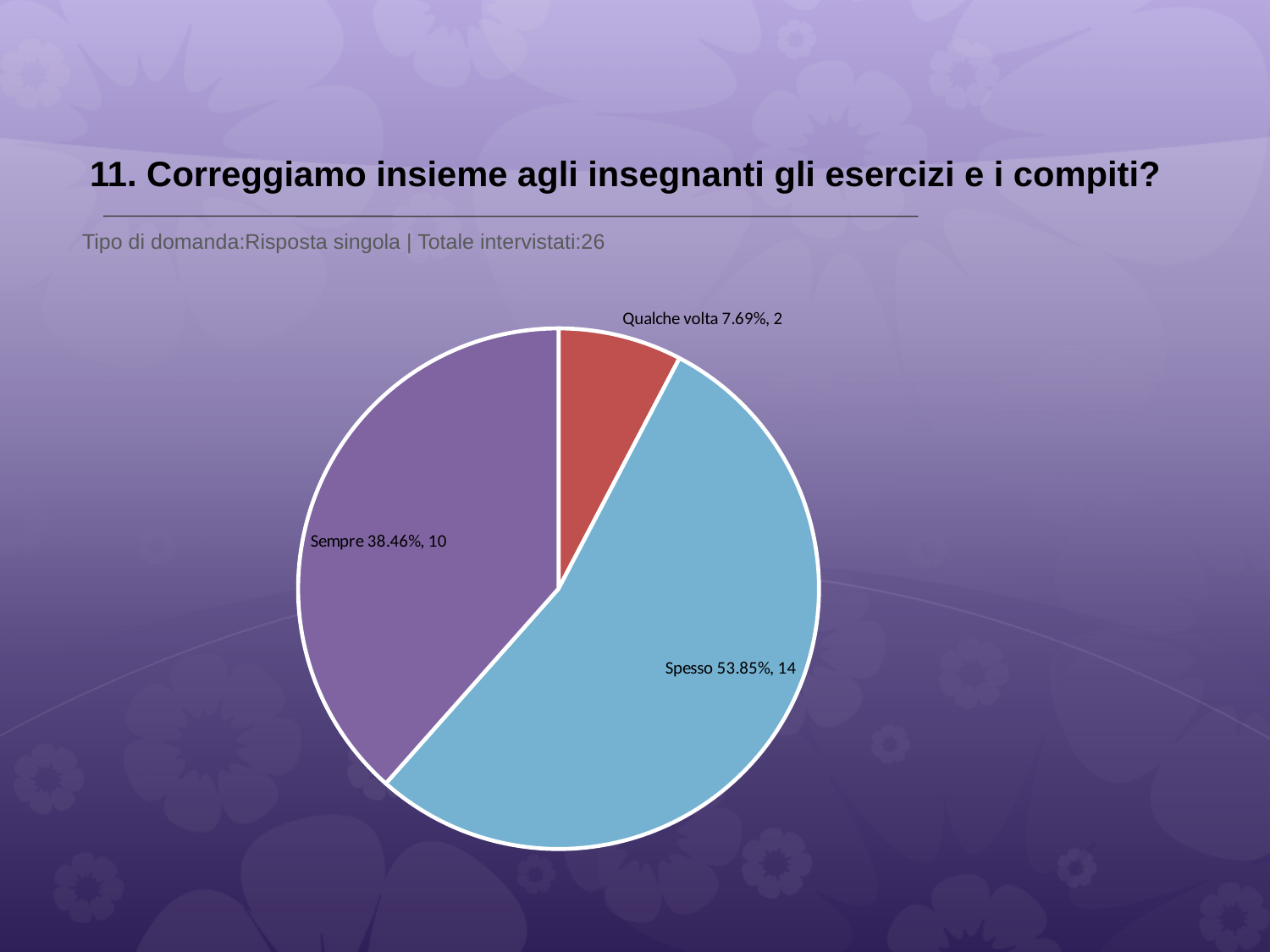
Which category has the largest slice? Spesso What percentage share does the 'Qualche volta' slice have? 7.69% How many respondents answered 'Sempre'? 10 How many respondents answered 'Qualche volta'? 2 What kind of chart is shown on the slide? pie chart How many respondents answered 'Spesso'? 14 How many slices does the pie chart have? 3 What percentage share does the 'Sempre' slice have? 38.46% What percentage share does the 'Spesso' slice have? 53.85% Which category has the smallest slice? Qualche volta What is the difference in respondent count between 'Spesso' and 'Sempre'? 4 Which has more respondents, 'Sempre' or 'Qualche volta'? Sempre